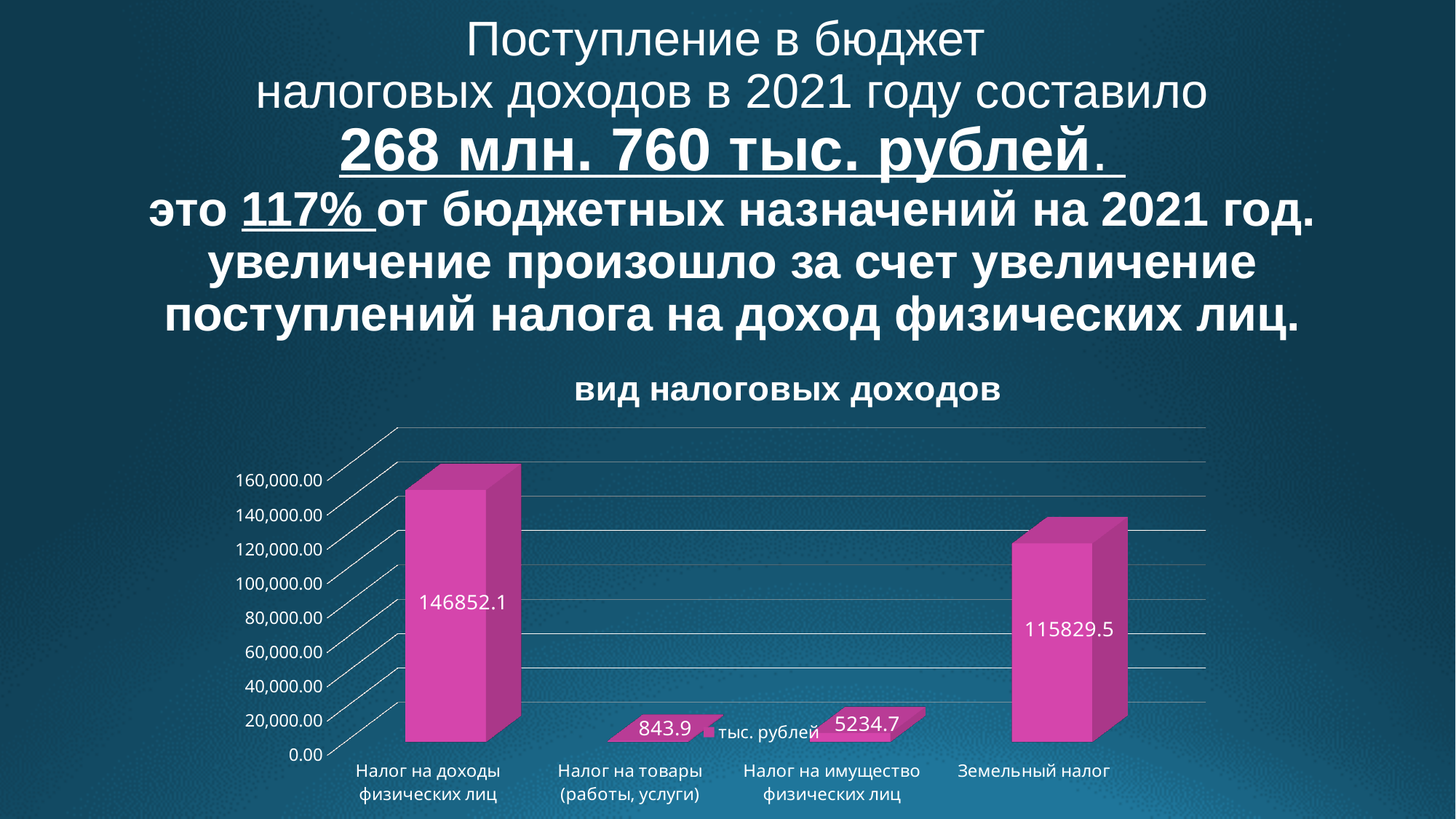
Is the value for Земельный налог greater or less than 100,000.00? greater What is the value for Налог на доходы физических лиц? 146852.1 What is the value for Налог на имущество физических лиц? 5234.7 Which is larger: the value for Налог на имущество физических лиц or the value for Налог на товары (работы, услуги)? Налог на имущество физических лиц What is the difference between the values for Налог на доходы физических лиц and Земельный налог? 31022.6 What is the value for Земельный налог? 115829.5 Which category has the highest value? Налог на доходы физических лиц What is the value for Налог на товары (работы, услуги)? 843.9 What is the title of the chart? вид налоговых доходов Which category has the lowest value? Налог на товары (работы, услуги) What kind of chart is shown on the slide? bar chart How many categories are shown on the chart? 4